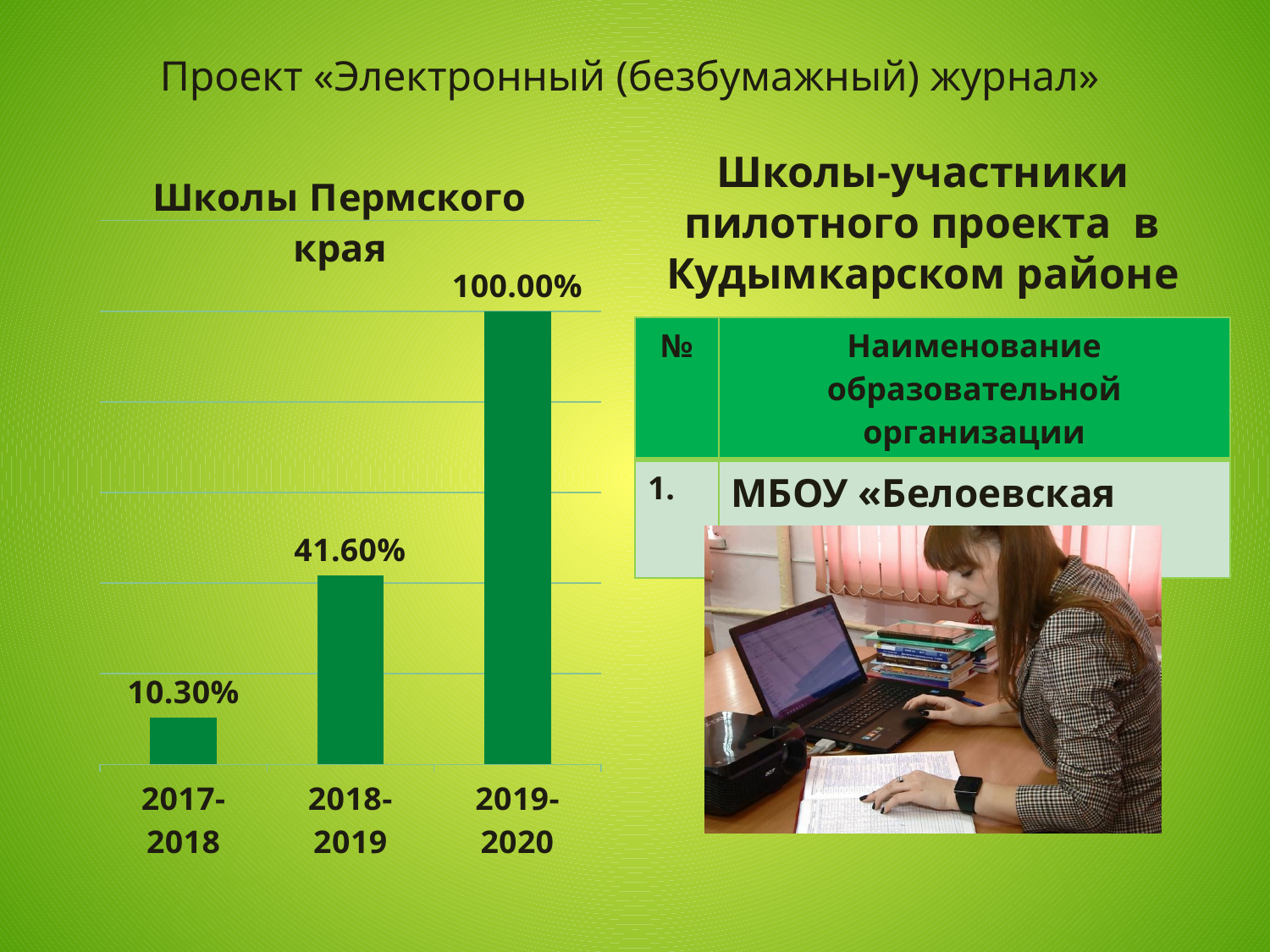
Which category has the highest value in the chart "Школы Пермского края"? 2019-2020 What is the difference between the values for 2019-2020 and 2018-2019 in the chart "Школы Пермского края"? 58.40% Which is larger in the chart "Школы Пермского края": the value for 2017-2018 or the value for 2018-2019? 2018-2019 What kind of chart is "Школы Пермского края"? Bar chart What is the value for 2017-2018 in the chart "Школы Пермского края"? 10.30% How many categories are shown on the x axis of the chart "Школы Пермского края"? 3 What is the title of the chart on the left side of the slide? Школы Пермского края Which category has the lowest value in the chart "Школы Пермского края"? 2017-2018 What is the value for 2018-2019 in the chart "Школы Пермского края"? 41.60% Do the values in the chart "Школы Пермского края" rise or fall from 2017-2018 to 2019-2020? Rise What is the difference between the values for 2018-2019 and 2017-2018 in the chart "Школы Пермского края"? 31.30% What is the value for 2019-2020 in the chart "Школы Пермского края"? 100.00%